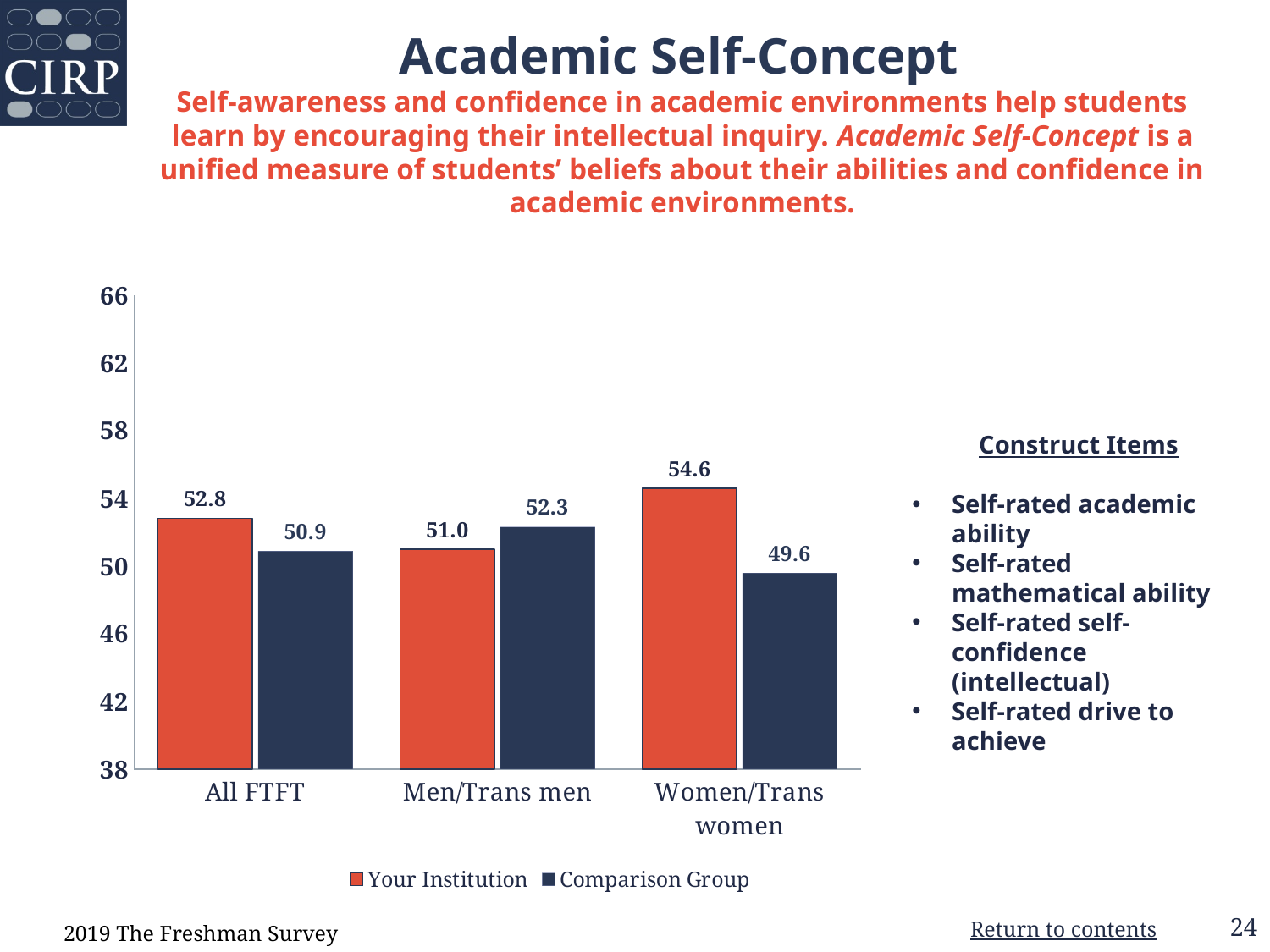
What kind of chart is shown on the slide? bar chart What is the Comparison Group value for Men/Trans men? 52.3 Is the Your Institution value for Women/Trans women greater or less than 54? greater What colour are the Comparison Group bars? dark navy blue For Men/Trans men, which is larger: Your Institution or Comparison Group? Comparison Group How many categories are shown on the x axis? 3 What is the difference between the Your Institution and Comparison Group values for Women/Trans women? 5.0 What is the Your Institution value for All FTFT? 52.8 Which category has the lowest Comparison Group value? Women/Trans women Which category has the highest Your Institution value? Women/Trans women What is the Comparison Group value for Women/Trans women? 49.6 How many series does the legend list? 2